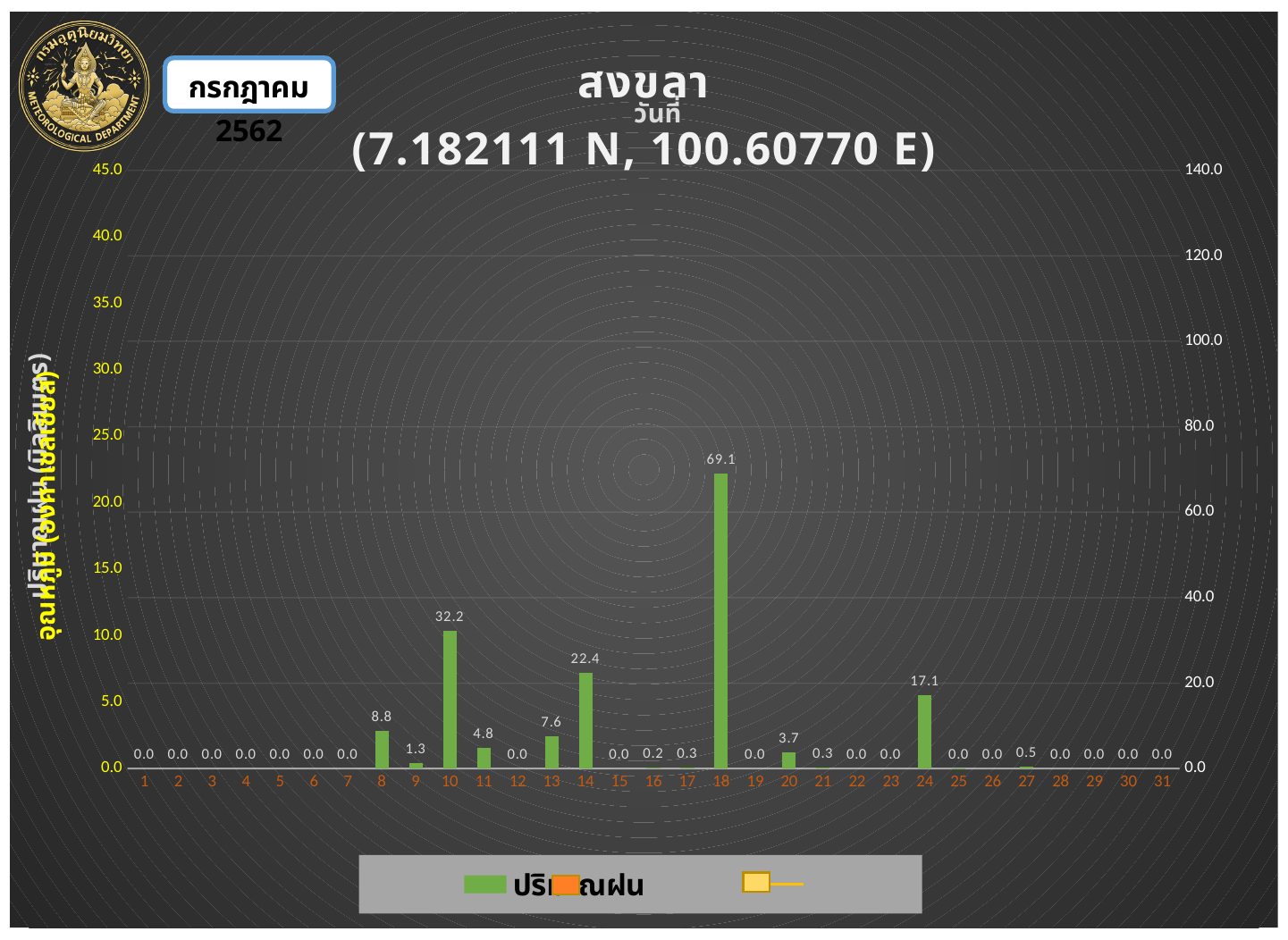
Which day has the highest value? 18 What kind of chart is this? bar chart How many days are shown on the x axis? 31 Is the value for day 18 greater or less than 60 on the right-hand axis? greater What is the value shown for day 8? 8.8 What is the difference between the values for day 18 and day 10? 36.9 What is the value shown for day 14? 22.4 What is the value shown for day 18? 69.1 Which has the larger value, day 14 or day 24? day 14 What is the value shown for day 10? 32.2 What coordinates are given in the chart title? 7.182111 N, 100.60770 E What is the value shown for day 24? 17.1